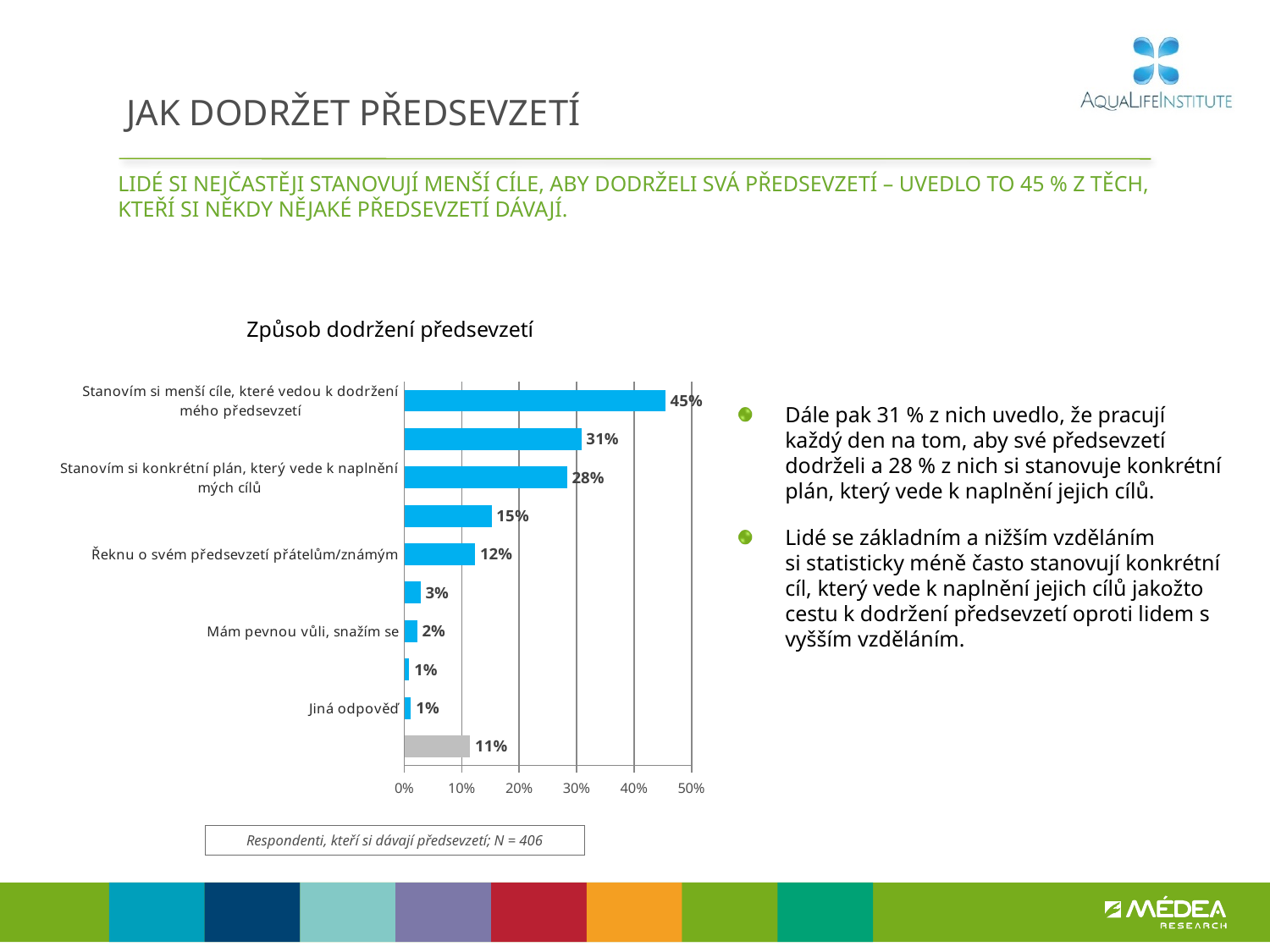
Which is larger: the value for "Řeknu o svém předsevzetí přátelům/známým" or the value for "Mám pevnou vůli, snažím se"? Řeknu o svém předsevzetí přátelům/známým Is the value for "Řeknu o svém předsevzetí přátelům/známým" greater or less than 10%? greater What is the value for "Stanovím si konkrétní plán, který vede k naplnění mých cílů"? 28% Which category has the highest value in the chart? Stanovím si menší cíle, které vedou k dodržení mého předsevzetí What is the value for "Jiná odpověď"? 1% What kind of chart is shown on the slide? bar chart What is the value for "Stanovím si menší cíle, které vedou k dodržení mého předsevzetí"? 45% What is the value for "Mám pevnou vůli, snažím se"? 2% What is the title of the chart? Způsob dodržení předsevzetí How many bars are plotted in the chart? 10 What is the difference between the values for "Stanovím si menší cíle, které vedou k dodržení mého předsevzetí" and "Stanovím si konkrétní plán, který vede k naplnění mých cílů"? 17 percentage points What is the value for "Řeknu o svém předsevzetí přátelům/známým"? 12%